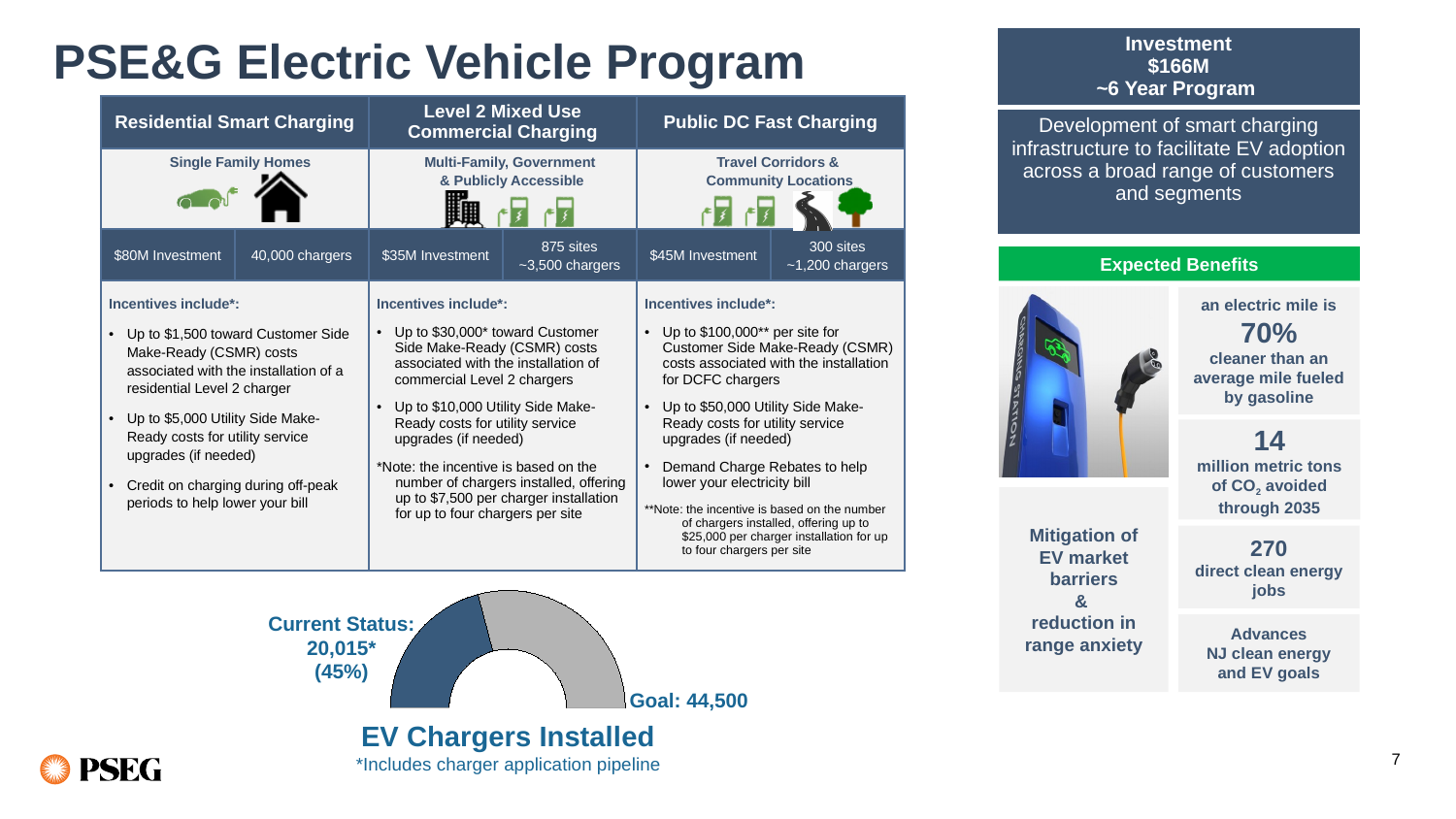
In the "EV Chargers Installed" chart, what is the current status value of chargers installed? 20,015* How many segments does the "EV Chargers Installed" donut chart have? 2 What does the asterisk on the current status value in the "EV Chargers Installed" chart indicate? Includes charger application pipeline In the "EV Chargers Installed" chart, which segment is larger: the installed (blue) portion or the remaining (gray) portion? The remaining (gray) portion In the "EV Chargers Installed" chart, how many chargers remain to reach the goal of 44,500 from the current status of 20,015? 24,485 What is the title of the chart at the bottom of the slide? EV Chargers Installed What kind of chart is the "EV Chargers Installed" chart? Donut (pie) chart In the "EV Chargers Installed" chart, is the current status share greater or less than 50%? less In the "EV Chargers Installed" chart, what is the goal number of chargers? 44,500 In the "EV Chargers Installed" chart, what share of the goal does the current status represent? 45%